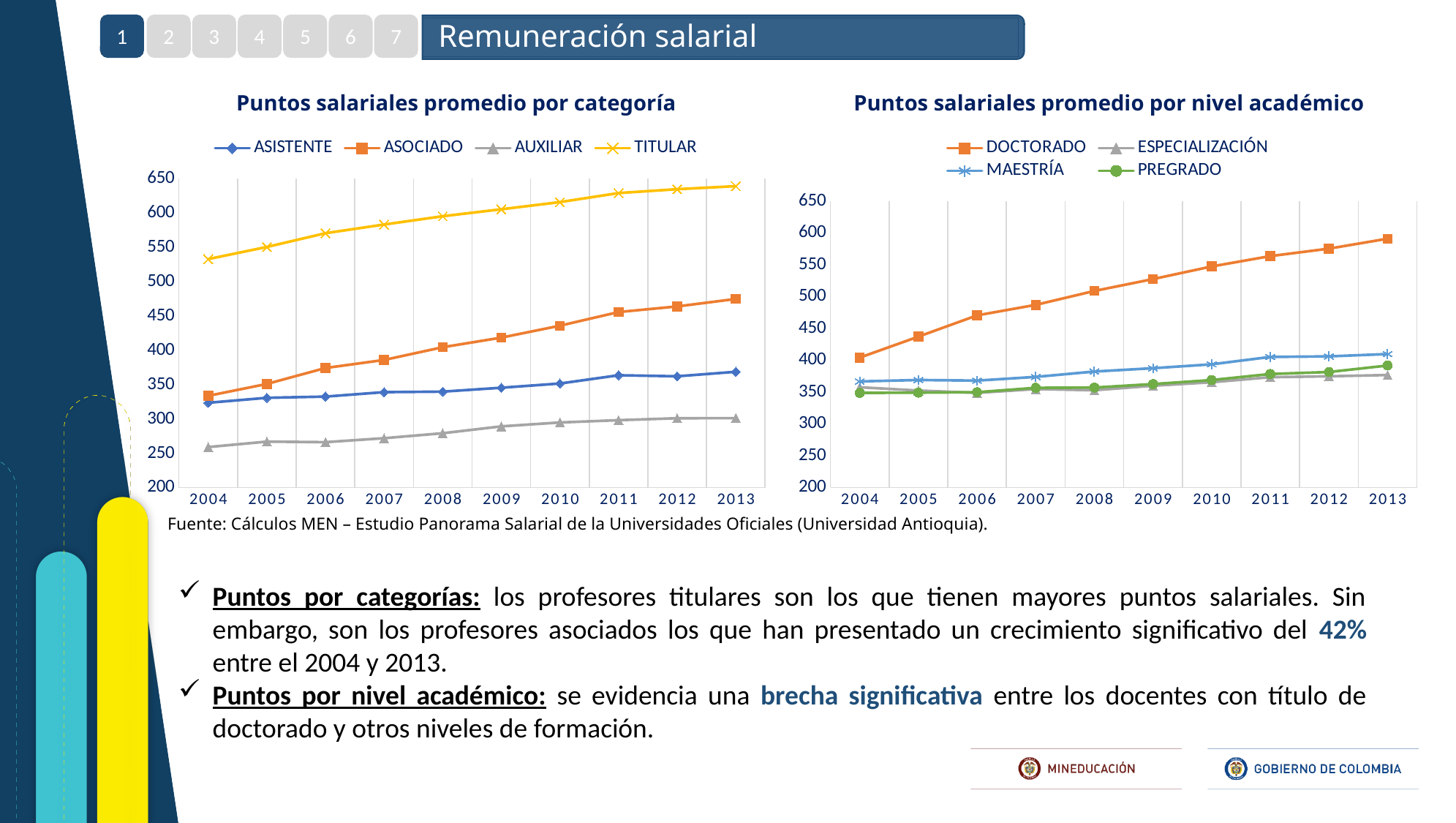
In the left chart, 'Puntos salariales promedio por categoría', is the value for TITULAR in 2004 greater or less than 500? greater In the right chart, 'Puntos salariales promedio por nivel académico', is the value for DOCTORADO in 2013 greater or less than 550? greater In the left chart, 'Puntos salariales promedio por categoría', which series has the lowest values across all years? AUXILIAR What kind of chart is the left chart, 'Puntos salariales promedio por categoría'? line chart In the right chart, 'Puntos salariales promedio por nivel académico', does the DOCTORADO series rise or fall from 2004 to 2013? rise In the left chart, 'Puntos salariales promedio por categoría', is the value for ASOCIADO in 2013 greater or less than 500? less How many years are plotted on the x axis of the right chart, 'Puntos salariales promedio por nivel académico'? 10 In the left chart, 'Puntos salariales promedio por categoría', which is larger in 2013: ASISTENTE or AUXILIAR? ASISTENTE In the right chart, 'Puntos salariales promedio por nivel académico', which series has the highest values across all years? DOCTORADO Which series in the right chart, 'Puntos salariales promedio por nivel académico', is drawn with green circle markers? PREGRADO In the left chart, 'Puntos salariales promedio por categoría', which series has the highest values across all years? TITULAR How many series does the legend of the left chart, 'Puntos salariales promedio por categoría', list? 4